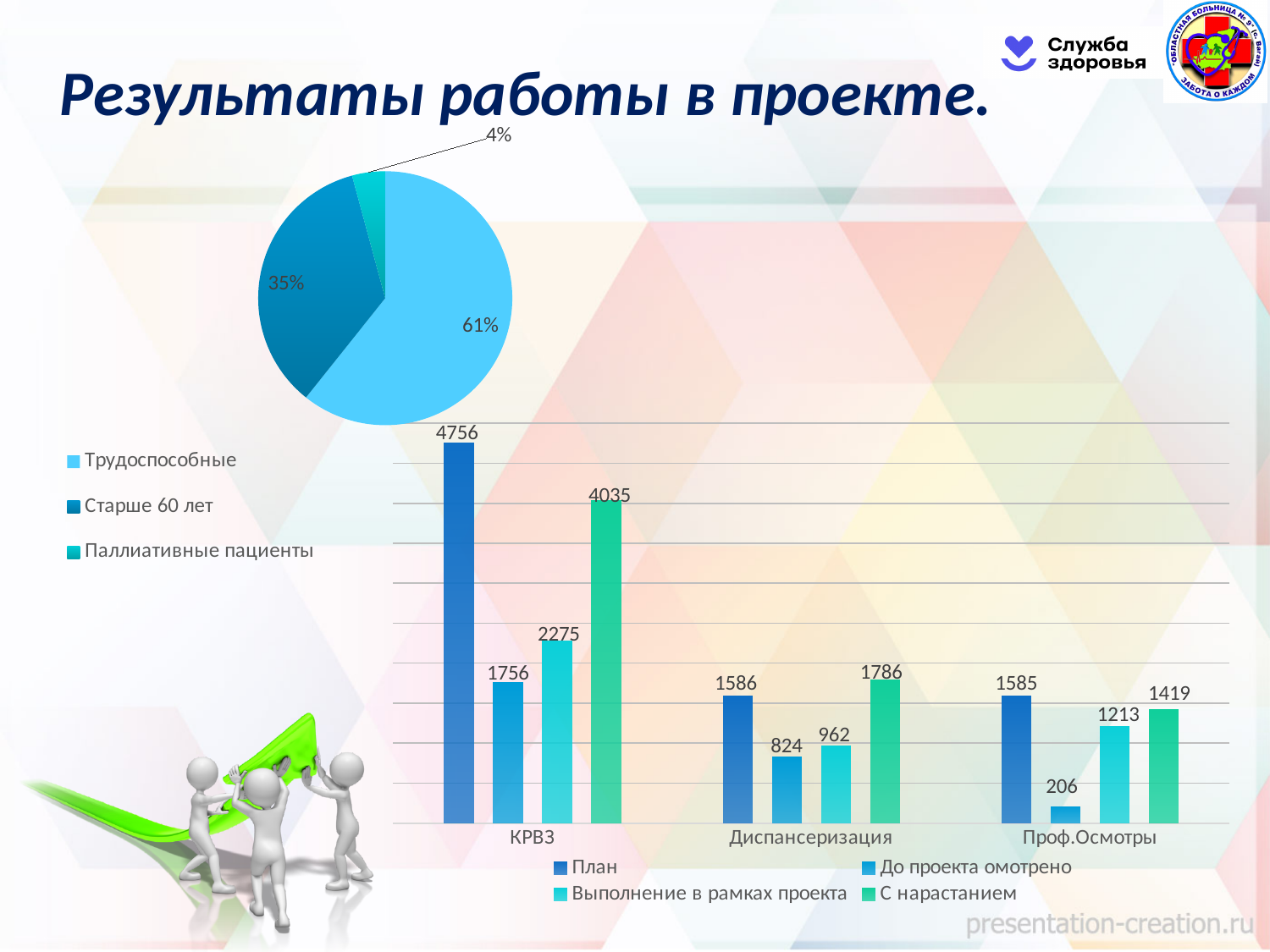
What type of chart is the lower chart on the slide? Bar chart In the bar chart, which is larger for Диспансеризация: Выполнение в рамках проекта or До проекта омотрено? Выполнение в рамках проекта In the pie chart, which category has the largest slice? Трудоспособные How many slices does the pie chart have? 3 In the bar chart, what is the value of С нарастанием for Диспансеризация? 1786 In the bar chart, what is the difference between План and С нарастанием for КРВЗ? 721 In the bar chart, what is the value of План for КРВЗ? 4756 How many series does the legend of the bar chart list? 4 In the bar chart, which category has the highest План value? КРВЗ In the pie chart, what share is shown for Трудоспособные? 61% In the pie chart, what share is shown for Паллиативные пациенты? 4% In the bar chart, what is the value of До проекта омотрено for Проф.Осмотры? 206